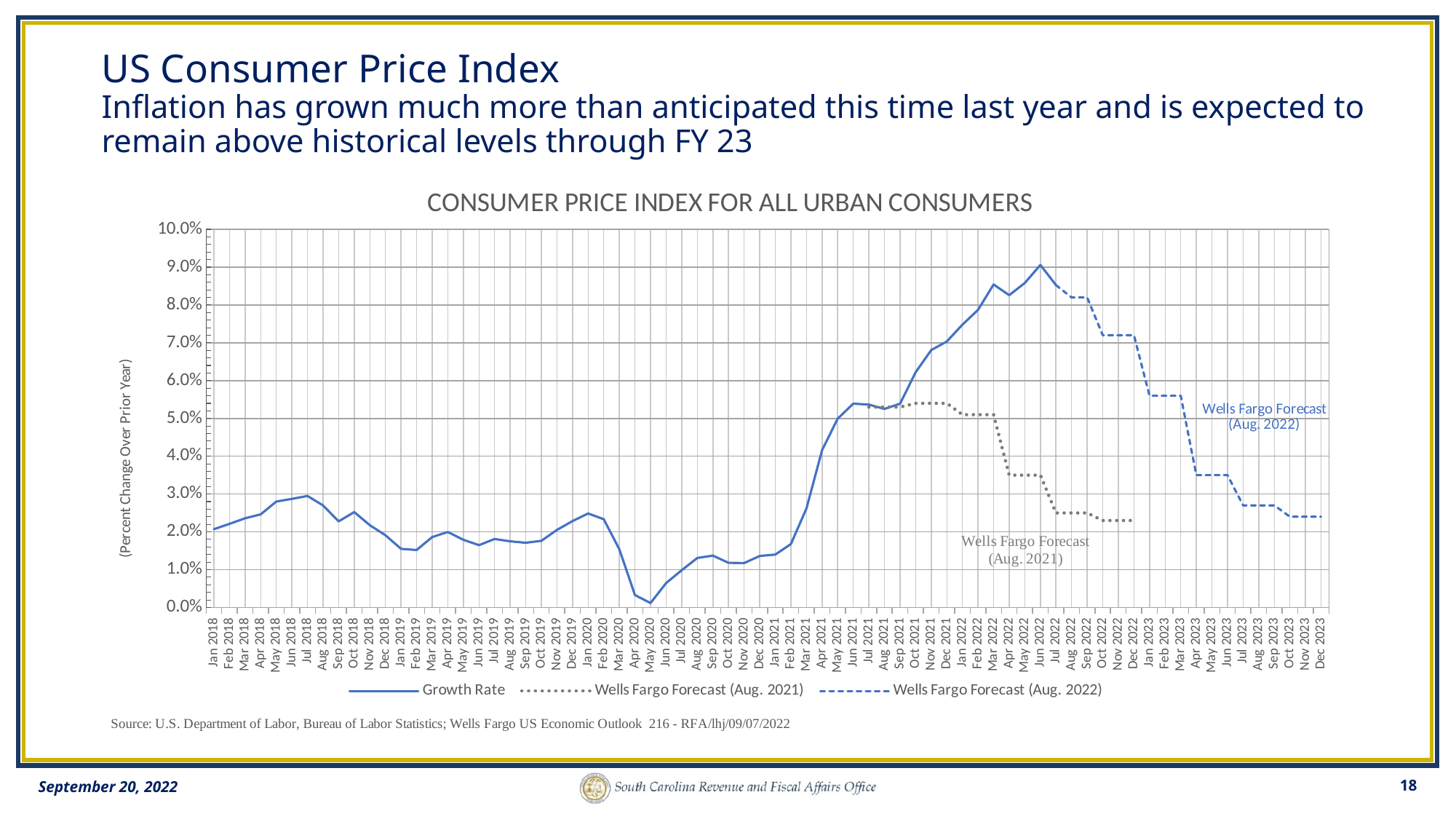
For Dec 2022, which series shows the larger value: Wells Fargo Forecast (Aug. 2021) or Wells Fargo Forecast (Aug. 2022)? Wells Fargo Forecast (Aug. 2022) Does the Wells Fargo Forecast (Aug. 2022) series rise or fall from Jul 2022 to Dec 2023? fall Is the Wells Fargo Forecast (Aug. 2022) value for Dec 2023 greater or less than 3.0%? less In which month does the Growth Rate series reach its lowest value? May 2020 What kind of chart is shown on the slide? line chart What is the title of the chart? CONSUMER PRICE INDEX FOR ALL URBAN CONSUMERS How many series does the chart's legend list? 3 Is the Growth Rate value for May 2020 greater or less than 1.0%? less In which month does the Growth Rate series reach its highest value? Jun 2022 Is the Wells Fargo Forecast (Aug. 2021) value for Dec 2022 greater or less than 3.0%? less What is the label on the vertical axis of the chart? (Percent Change Over Prior Year)